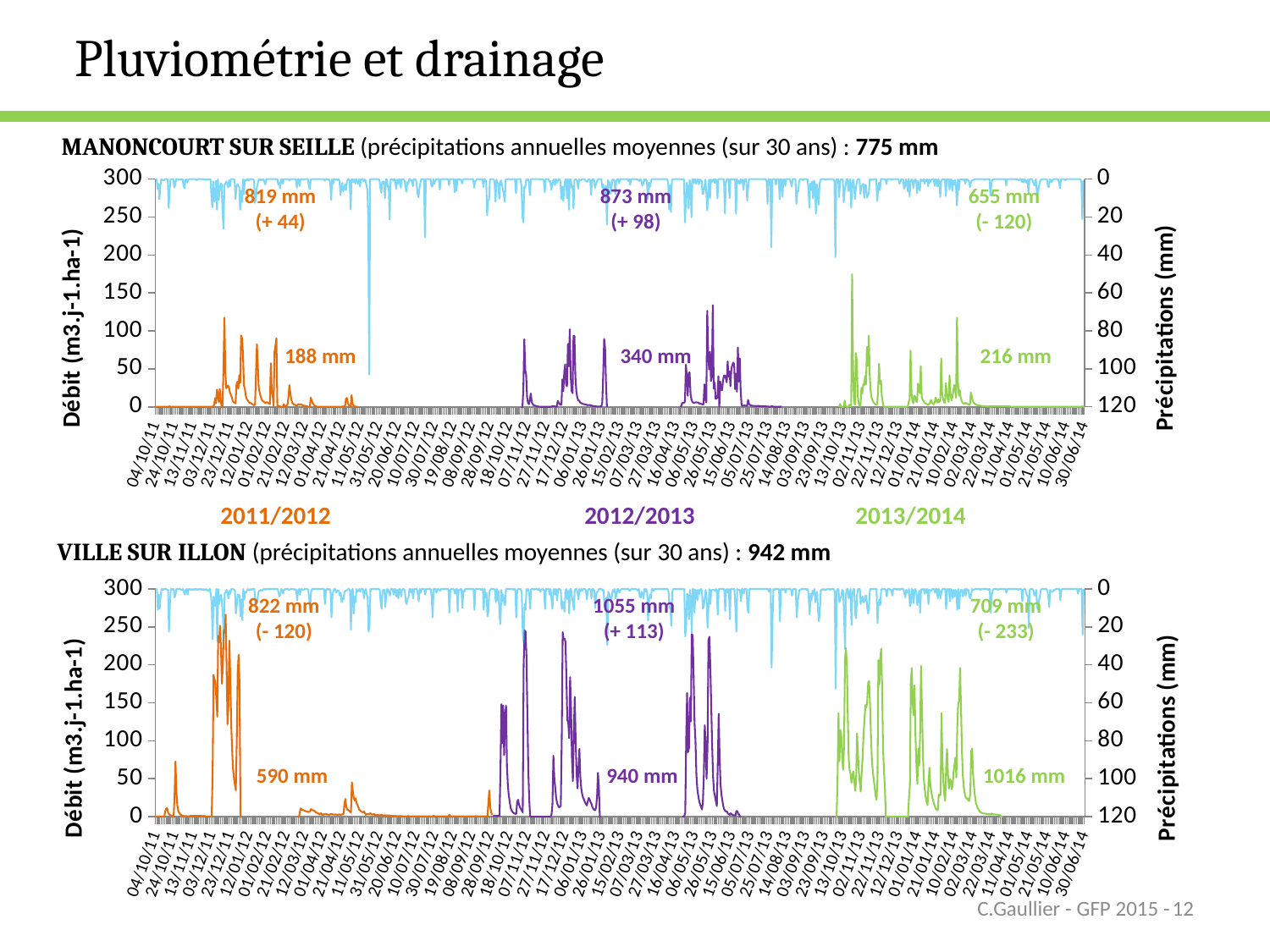
On the Ville sur Illon chart, what annual precipitation is annotated for 2013/2014? 709 mm On the Ville sur Illon chart, which season has the highest annotated drainage total? 2013/2014 On the Manoncourt sur Seille chart, which season has the highest annotated drainage total? 2012/2013 On the Manoncourt sur Seille chart, which season has the lowest annotated annual precipitation? 2013/2014 On the Ville sur Illon chart, what is the difference between the annual precipitation of 2012/2013 and 2011/2012? 233 mm What is the 30-year average annual precipitation stated for Ville sur Illon? 942 mm On the Manoncourt sur Seille chart, what annual precipitation is annotated for 2012/2013? 873 mm On the Ville sur Illon chart, what drainage total is annotated for 2012/2013? 940 mm On the Ville sur Illon chart, is the annotated drainage total larger for 2011/2012 or for 2012/2013? 2012/2013 What kind of chart is used on the slide to show débit and précipitations? Line chart On the Manoncourt sur Seille chart, what is the difference between the drainage totals of 2012/2013 and 2013/2014? 124 mm On the Manoncourt sur Seille chart, what drainage total is annotated for 2011/2012? 188 mm